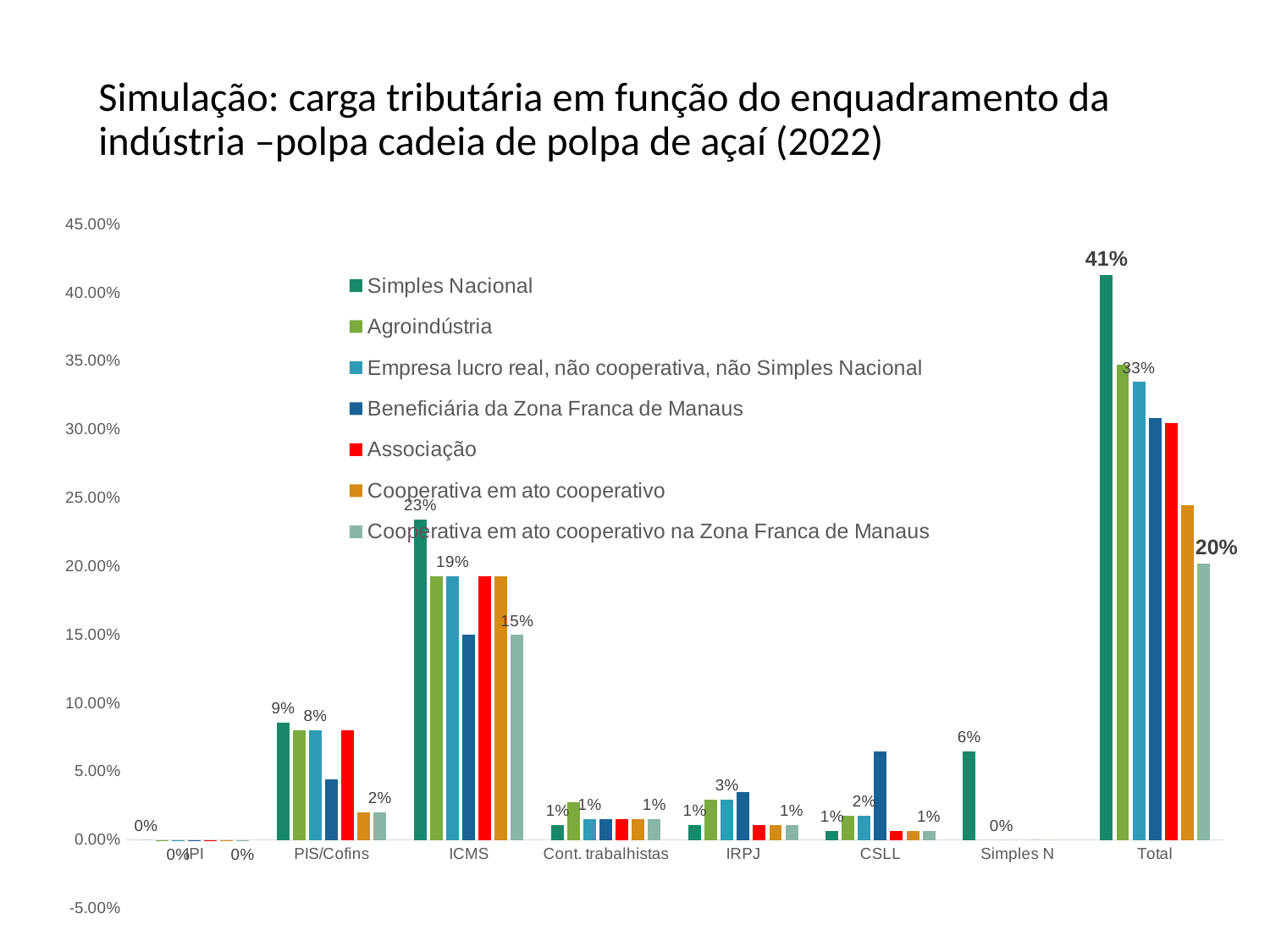
How many series does the legend list? 7 What is the value for Simples Nacional in the ICMS category? 23% What is the value for Simples Nacional in the Simples N category? 6% In which category is the Simples Nacional bar highest? Total Is the value for Beneficiária da Zona Franca de Manaus in the Total category greater or less than 25.00%? greater What kind of chart is shown on the slide? bar chart What is the value for Simples Nacional in the Total category? 41% How many categories are shown along the x axis? 8 What is the value for Cooperativa em ato cooperativo na Zona Franca de Manaus in the Total category? 20% In the ICMS category, which is larger: Simples Nacional or Agroindústria? Simples Nacional